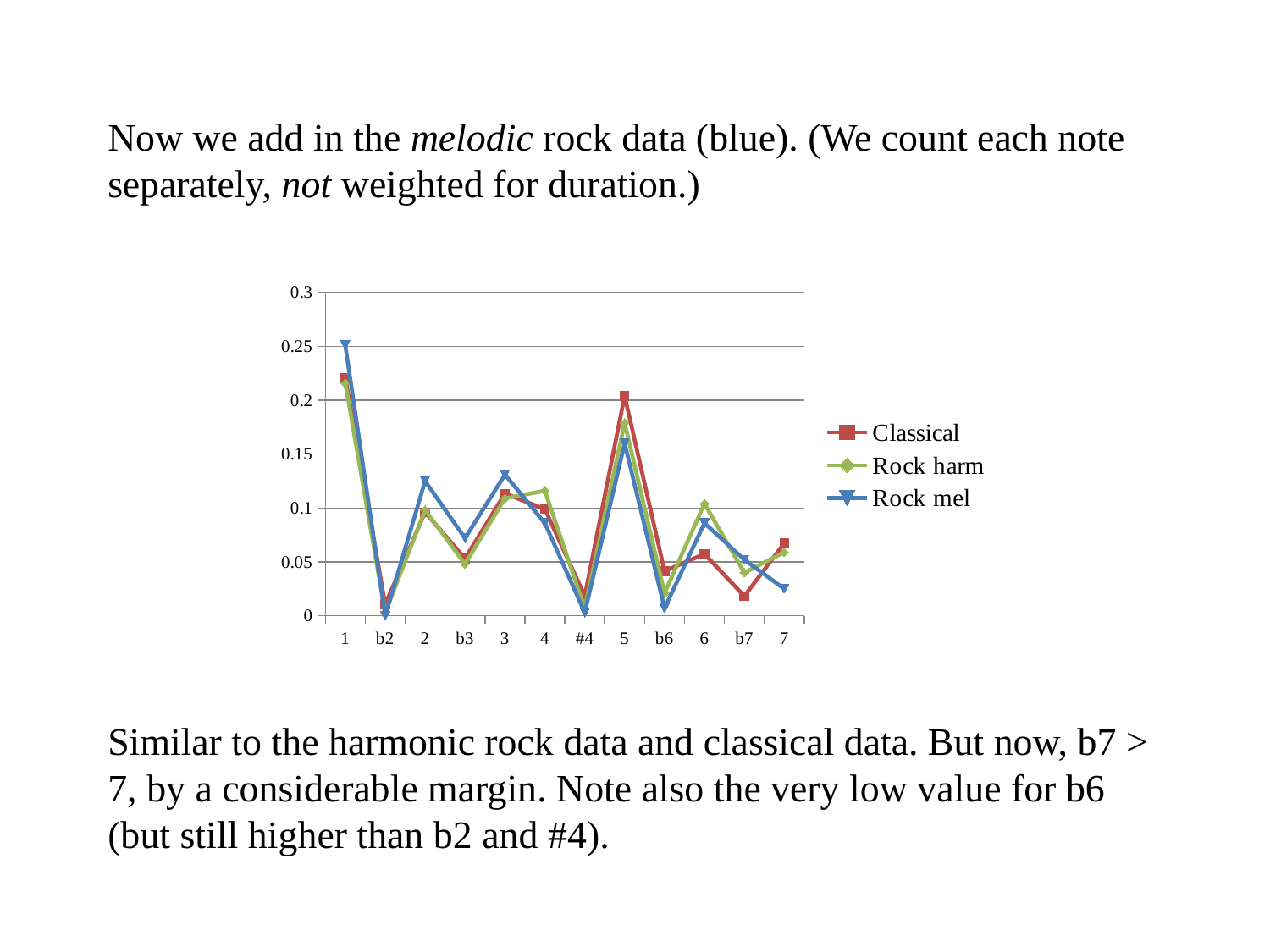
Is the Rock mel value for category 2 greater or less than 0.1? greater Is the Rock mel value for b6 greater or less than 0.05? less At category 5, which series has the larger value: Classical or Rock mel? Classical For the Rock mel series, which is larger: the value for b7 or the value for 7? b7 What kind of chart is shown on the slide? line chart How many categories are shown on the x axis? 12 Is the Classical value for b7 greater or less than 0.05? less Which series is drawn in blue? Rock mel How many series does the legend list? 3 For the Rock mel series, which category has the highest value? 1 For the Classical series, which category has the highest value? 1